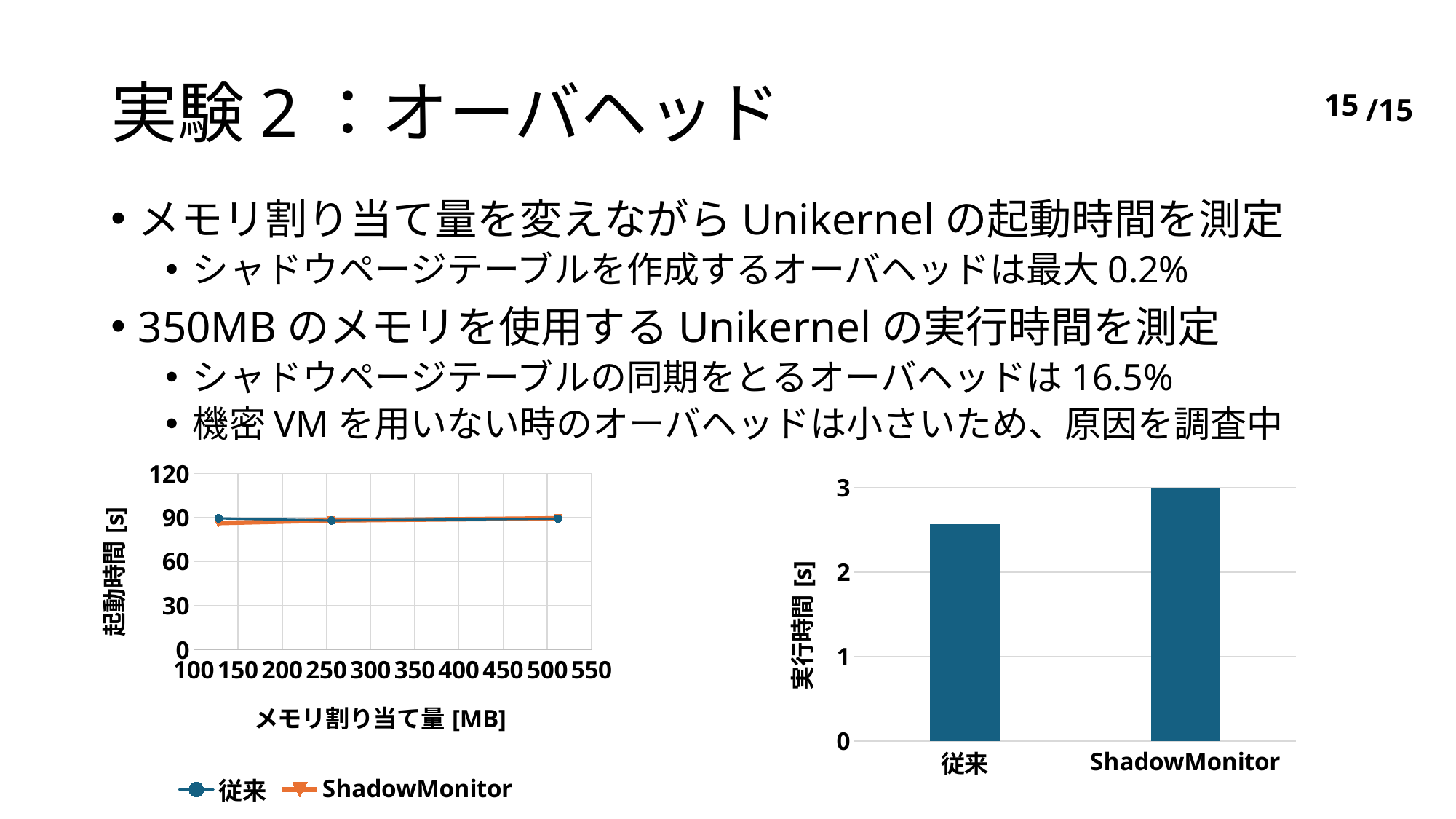
In the right chart, how many categories are shown on the x axis? 2 In the right chart, what kind of chart is it? bar chart In the left chart, what is the label of the x axis? メモリ割り当て量 [MB] In the left chart, is the 起動時間 value for 従来 at 250 MB greater or less than 60? greater In the left chart, what are the two series named in the legend? 従来 and ShadowMonitor In the right chart, which category has the highest 実行時間? ShadowMonitor In the left chart, what kind of chart is it? line chart In the left chart, is the 起動時間 value for ShadowMonitor at 500 MB greater or less than 120? less In the left chart, how many data points are plotted for the 従来 series? 3 In the left chart, how many series does the legend list? 2 In the right chart, which category has the lowest 実行時間? 従来 In the right chart, is the 実行時間 value for 従来 greater or less than 2? greater